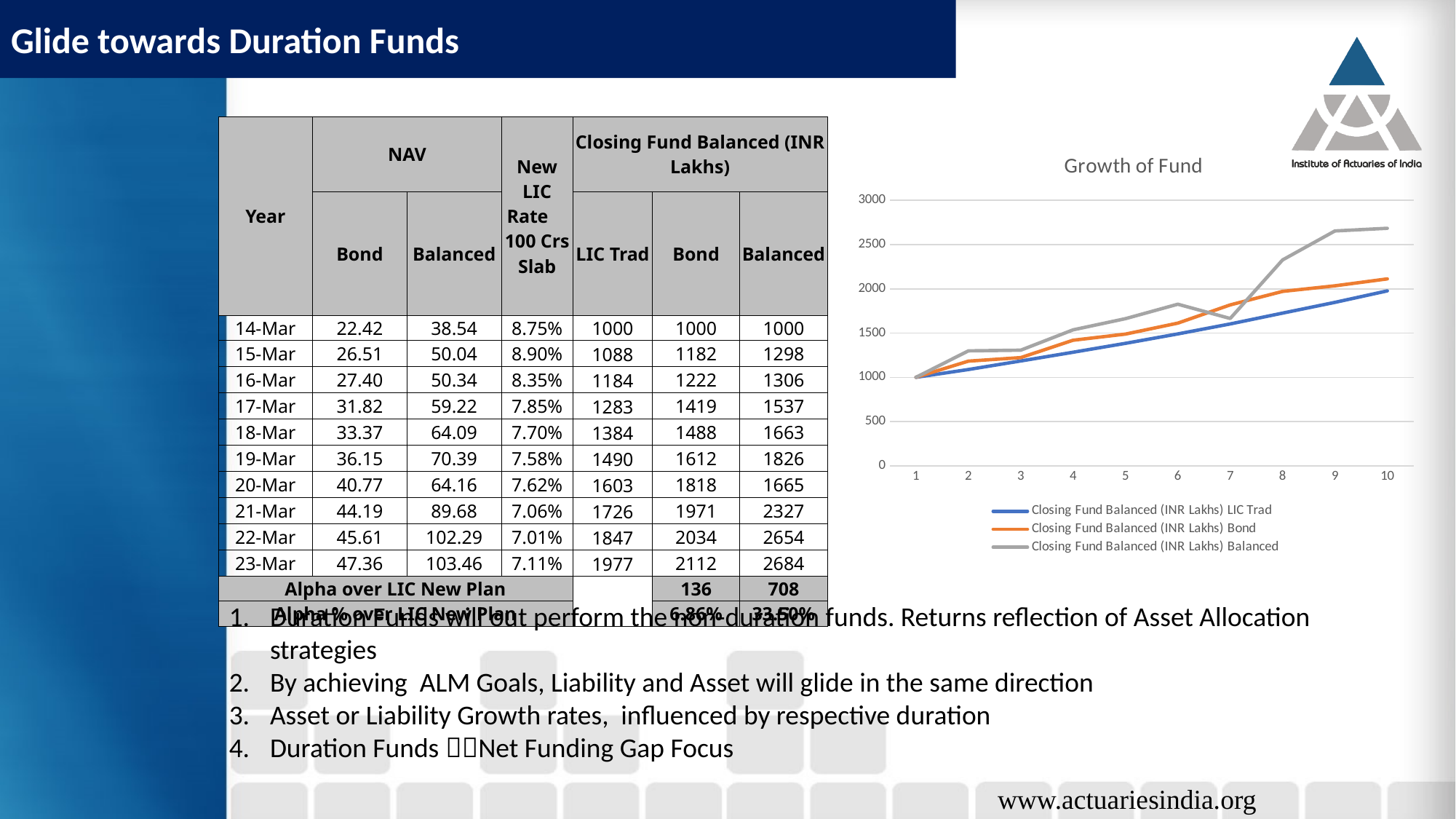
How many points are on the x axis of the "Growth of Fund" chart? 10 In the "Growth of Fund" chart, is the value of Closing Fund Balanced (INR Lakhs) Balanced at point 10 greater or less than 2500? greater In the "Growth of Fund" chart, what value do all three series start at on point 1? 1000 In the "Growth of Fund" chart, is the value of Closing Fund Balanced (INR Lakhs) Balanced at point 8 greater or less than 2000? greater What colour is the Closing Fund Balanced (INR Lakhs) Balanced line in the "Growth of Fund" chart? gray In the "Growth of Fund" chart, which series has the lowest value at point 10? Closing Fund Balanced (INR Lakhs) LIC Trad How many series does the legend of the "Growth of Fund" chart list? 3 What kind of chart is the "Growth of Fund" chart? line chart In the "Growth of Fund" chart, which series has the highest value at point 10? Closing Fund Balanced (INR Lakhs) Balanced In the "Growth of Fund" chart, is the value of Closing Fund Balanced (INR Lakhs) LIC Trad at point 5 greater or less than 1500? less In the "Growth of Fund" chart, at point 7, which is larger: the Bond series or the Balanced series? Bond In the "Growth of Fund" chart, does the Closing Fund Balanced (INR Lakhs) LIC Trad line rise or fall from point 1 to point 10? rise